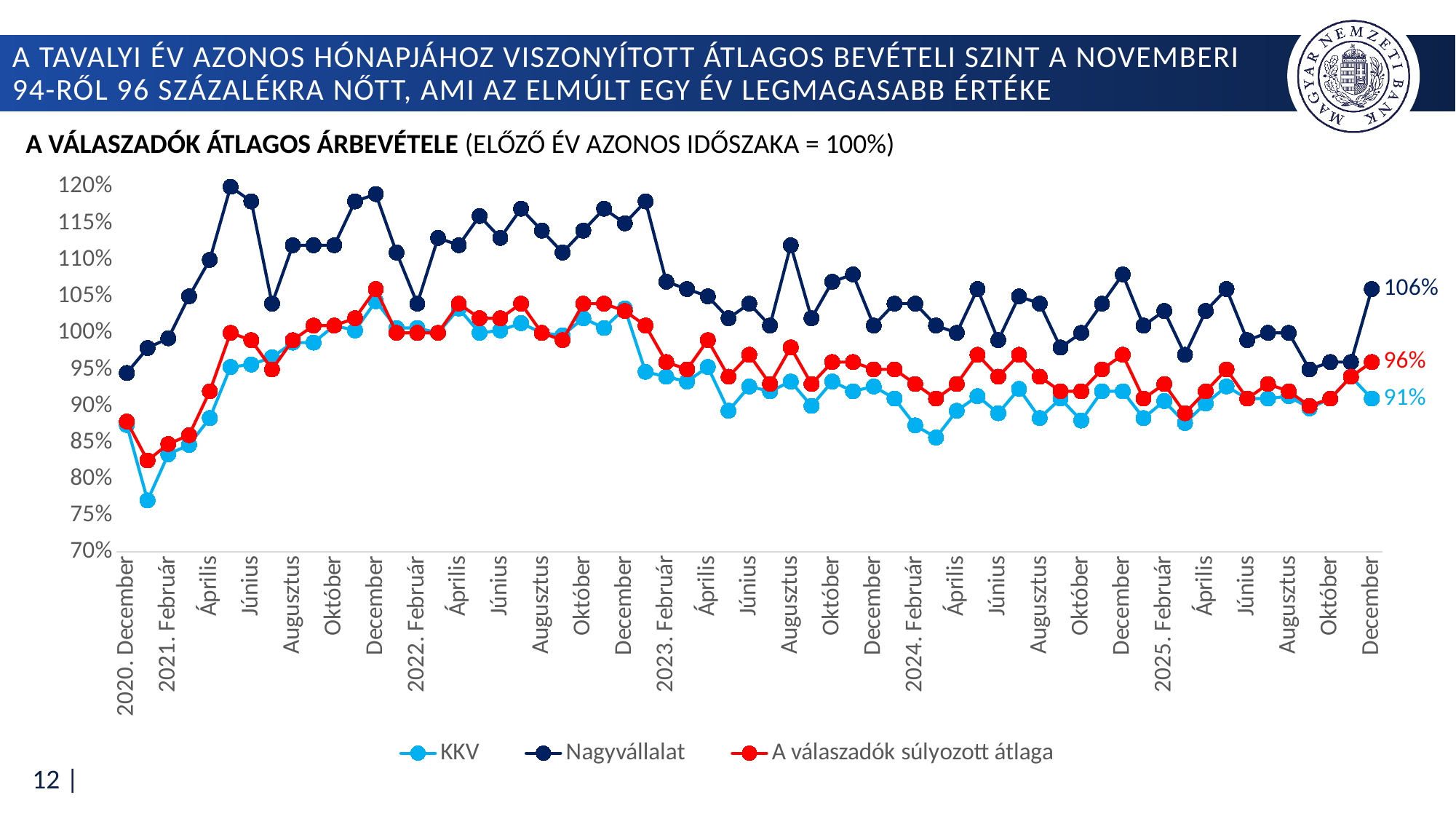
What is the value of 'A válaszadók súlyozott átlaga' at the last point (December 2025)? 96% At the last point (December 2025), which is larger: the KKV value or the 'A válaszadók súlyozott átlaga' value? A válaszadók súlyozott átlaga What is the value of the Nagyvállalat series at the last point (December 2025)? 106% At the last point (December 2025), what is the difference between the Nagyvállalat value and the KKV value? 15 percentage points Is the KKV value for 2021. Február greater or less than 85%? less What type of chart is shown on the slide? line chart What is the value of the KKV series at the last point (December 2025)? 91% At the last point (December 2025), which series has the highest value? Nagyvállalat Does the Nagyvállalat series rise or fall between 2023. Február and 2024. Február? fall At the last point (December 2025), which series has the lowest value? KKV How many series does the legend list? 3 Which colour is used for the 'A válaszadók súlyozott átlaga' series? red